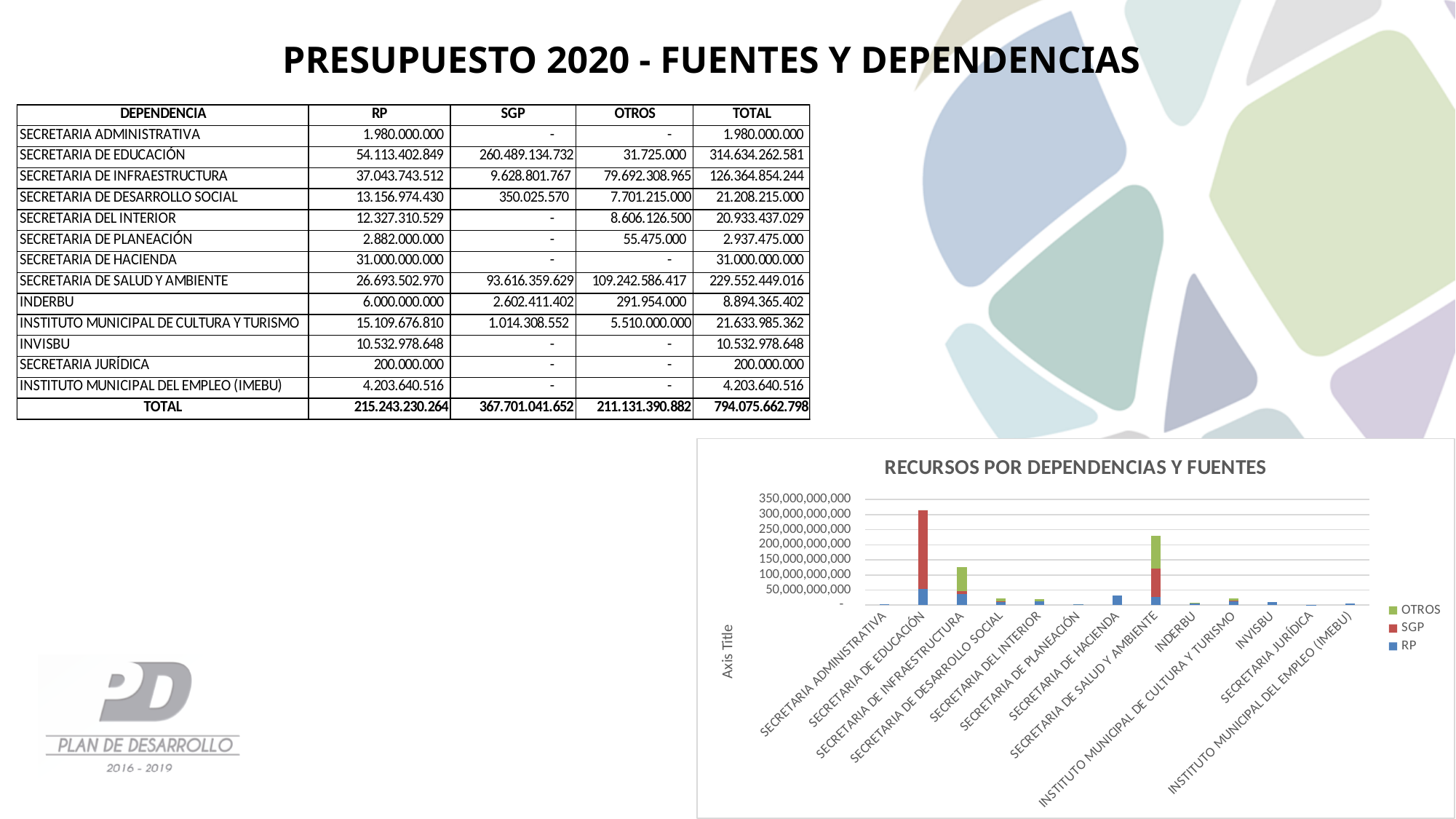
What kind of chart is shown on the slide? Stacked bar chart How many series does the chart legend list? 3 What is the title of the chart? RECURSOS POR DEPENDENCIAS Y FUENTES Which series in the chart is shown in red? SGP In the chart, which has the taller bar: SECRETARIA DE SALUD Y AMBIENTE or SECRETARIA DE INFRAESTRUCTURA? SECRETARIA DE SALUD Y AMBIENTE In the chart, is the total bar for SECRETARIA DE SALUD Y AMBIENTE greater or less than 200,000,000,000? greater Which dependencia has the tallest stacked bar in the chart? SECRETARIA DE EDUCACIÓN In the chart, is the total bar for SECRETARIA DE INFRAESTRUCTURA greater or less than 100,000,000,000? greater In the chart, which has the taller bar: SECRETARIA DE EDUCACIÓN or SECRETARIA DE SALUD Y AMBIENTE? SECRETARIA DE EDUCACIÓN In the chart, is the bar for SECRETARIA DE HACIENDA greater or less than 50,000,000,000? less How many dependencias (categories) are plotted on the x axis of the chart? 13